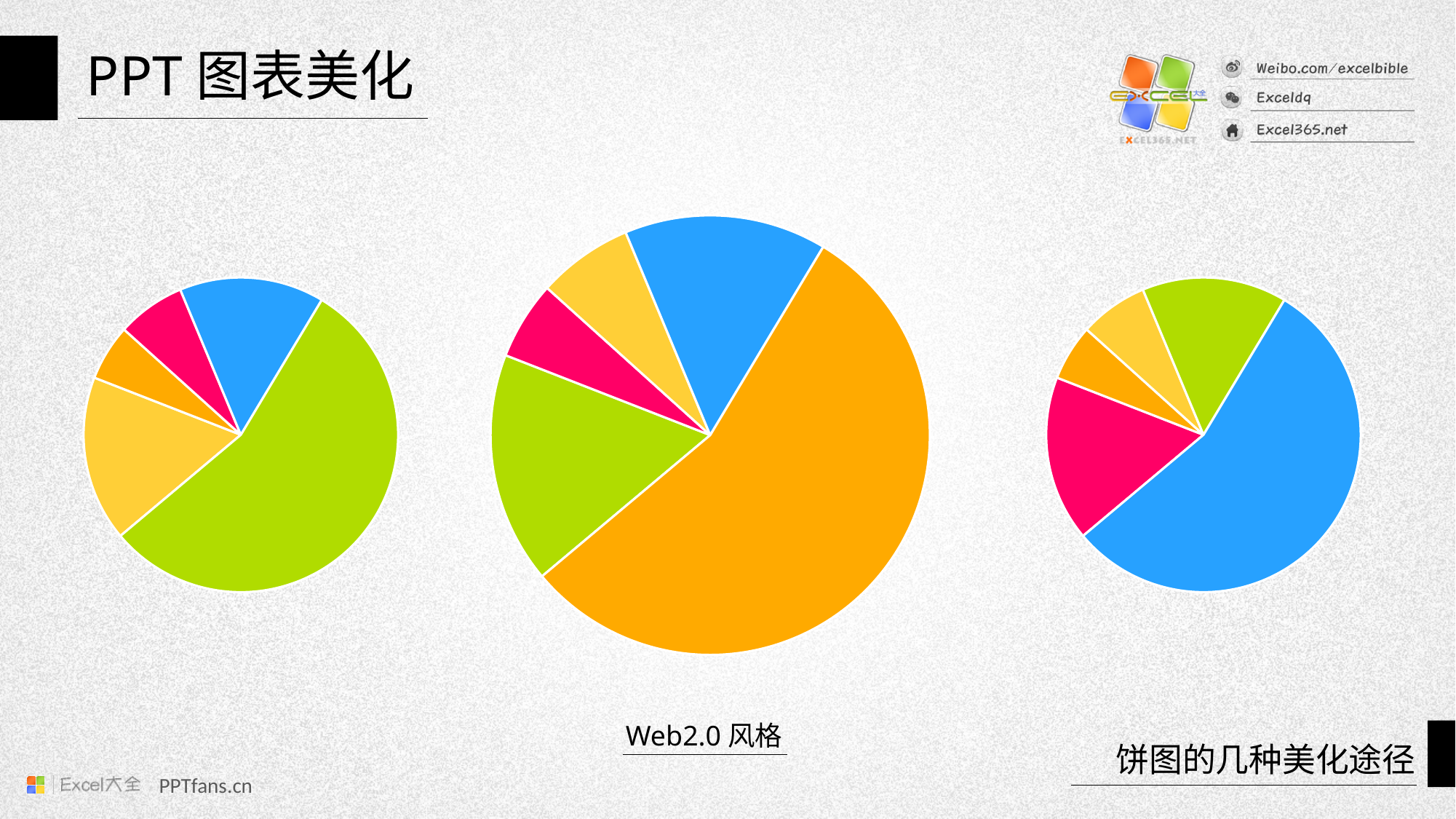
What caption is written below the middle pie chart? Web2.0 风格 In the middle pie chart, which colour slice is the largest? Orange In the right pie chart, which is larger, the blue slice or the pink slice? Blue How many charts are shown on the slide? 3 In the left pie chart, which colour slice is the largest? Green In the right pie chart, which colour slice is the largest? Blue In the middle pie chart, which is larger, the orange slice or the green slice? Orange How many slices does the middle pie chart have? 5 What kind of chart is the large chart in the middle of the slide? Pie chart How many slices does the left pie chart have? 5 What kind of chart is the chart on the left of the slide? Pie chart